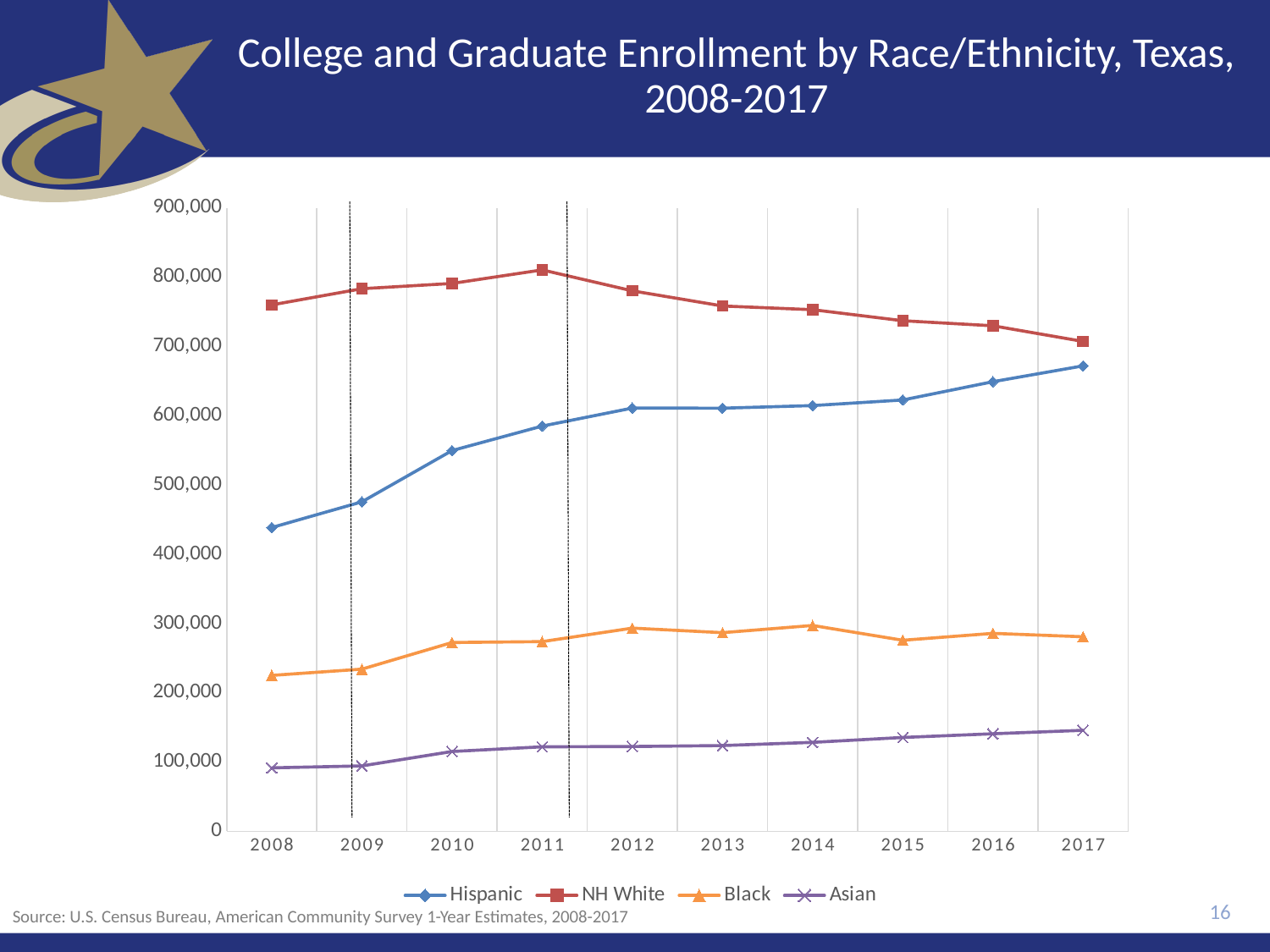
Is the Black value for 2008 greater or less than 300,000? less Is the Hispanic value for 2008 greater or less than 500,000? less Which race/ethnicity group has the lowest enrollment across all years shown? Asian What kind of chart is shown on the slide? line chart In which year does the NH White series reach its highest value? 2011 Does the NH White enrollment rise or fall from 2011 to 2017? fall In 2017, which is larger: Hispanic enrollment or NH White enrollment? NH White How many years are plotted along the x axis? 10 How many series does the legend list? 4 Is the Hispanic value for 2017 greater or less than 600,000? greater Which race/ethnicity group has the highest enrollment in 2008? NH White Does the Hispanic enrollment rise or fall from 2008 to 2017? rise